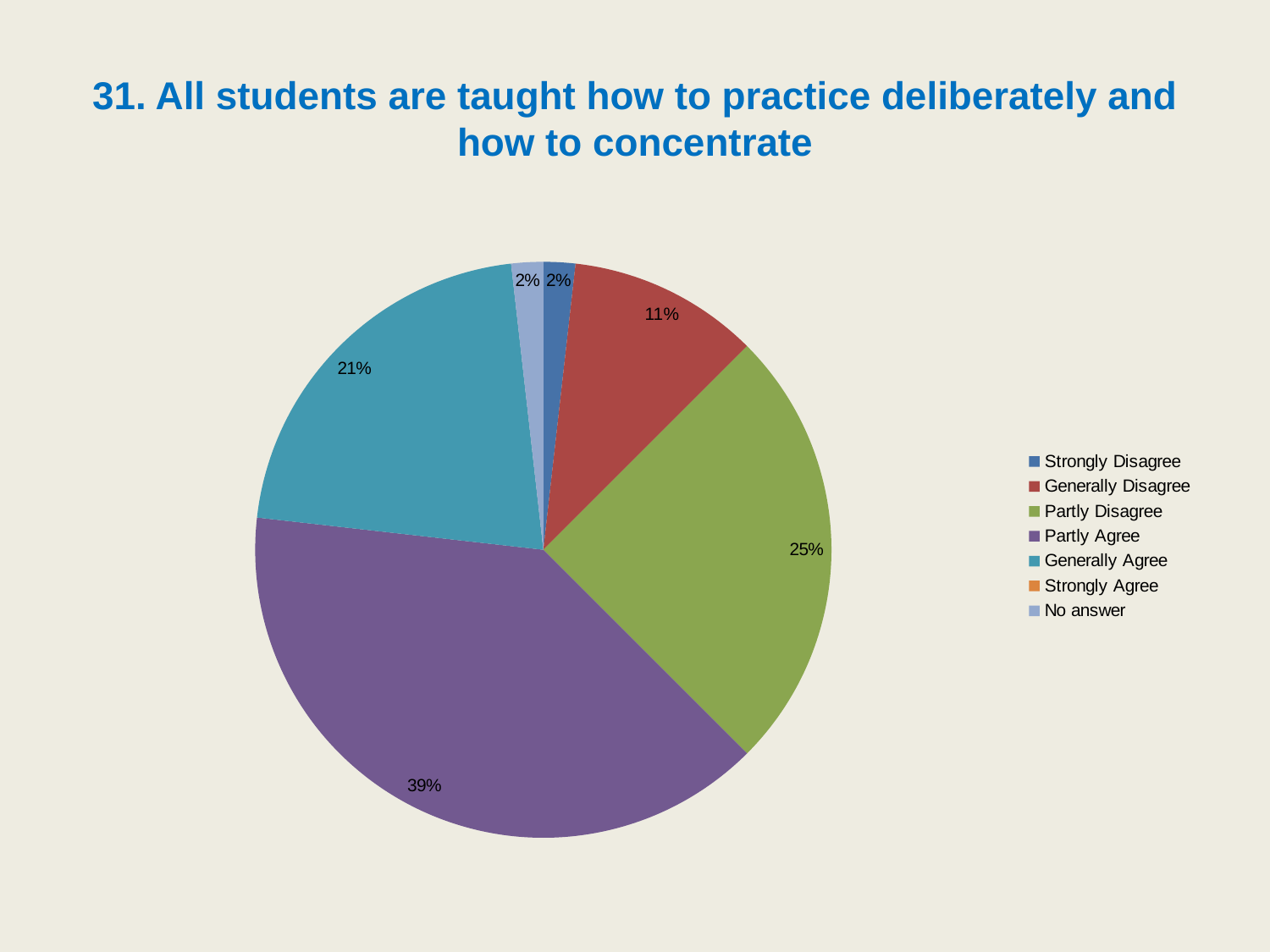
Which is larger, the share for Partly Disagree or the share for Generally Agree? Partly Disagree What percentage of respondents chose Generally Disagree? 11% What percentage of respondents chose Strongly Disagree? 2% How many entries does the legend list? 7 What is the difference in percentage points between Partly Agree and Partly Disagree? 14 What percentage of respondents chose Partly Disagree? 25% Which response category has the largest share of the pie? Partly Agree What kind of chart is shown on the slide? pie chart What is the title of the chart? 31. All students are taught how to practice deliberately and how to concentrate What is the difference in percentage points between Generally Agree and Generally Disagree? 10 What percentage of respondents chose Generally Agree? 21% What percentage of respondents chose Partly Agree? 39%